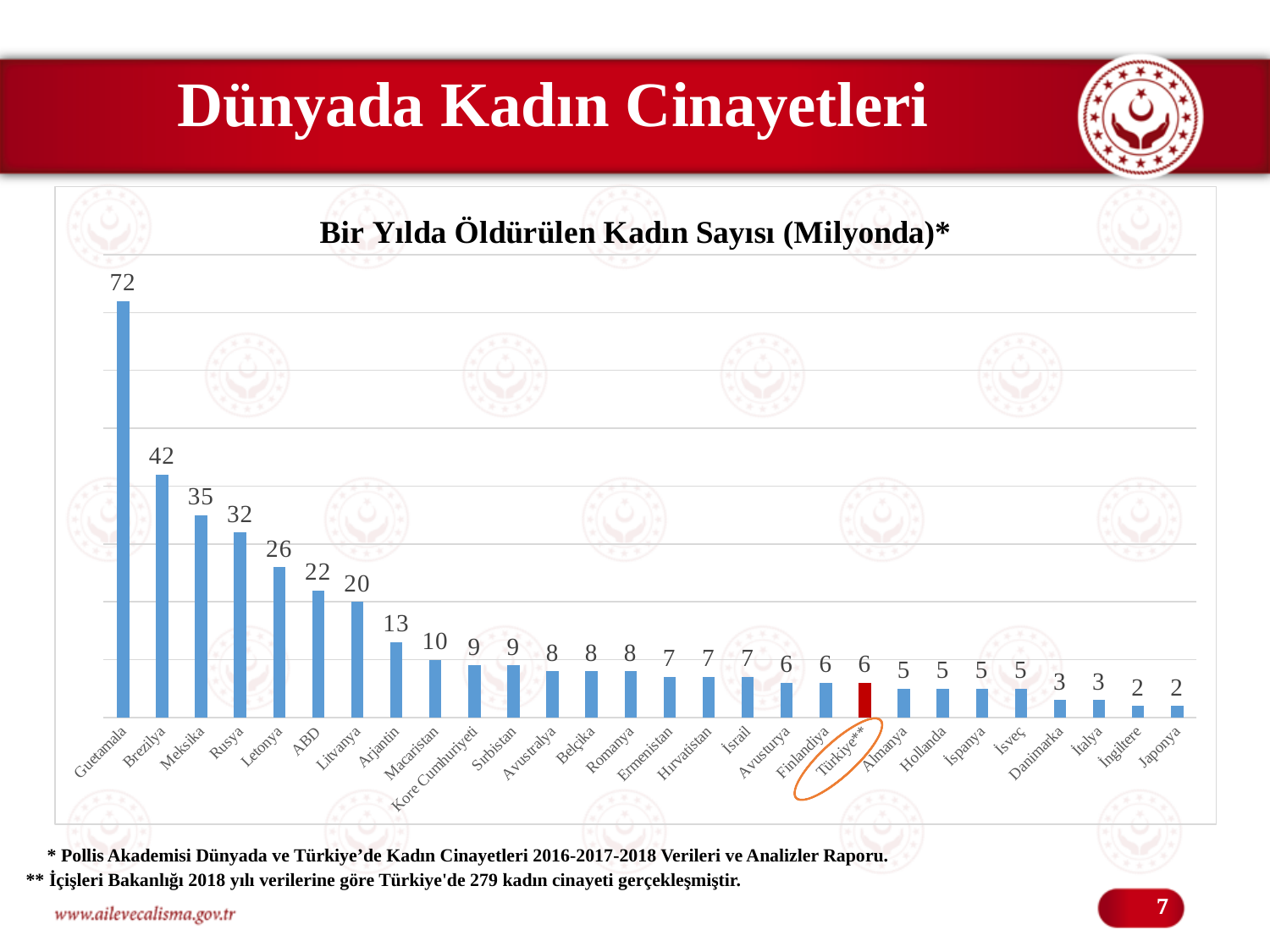
Do the values rise or fall from left to right along the x axis? Fall Which is larger, the value for Letonya or the value for ABD? Letonya What kind of chart is shown on the slide? Bar chart What is the value for Arjantin? 13 Which country's bar is coloured red instead of blue? Türkiye What is the difference between the values for Meksika and Rusya? 3 Which is larger, the value for Macaristan or the value for Danimarka? Macaristan How many countries are shown in the chart? 28 What is the value for Brezilya? 42 What is the value for Türkiye in the chart? 6 Which country has the highest value in the chart? Guetamala What is the difference between the values for Guetamala and Brezilya? 30